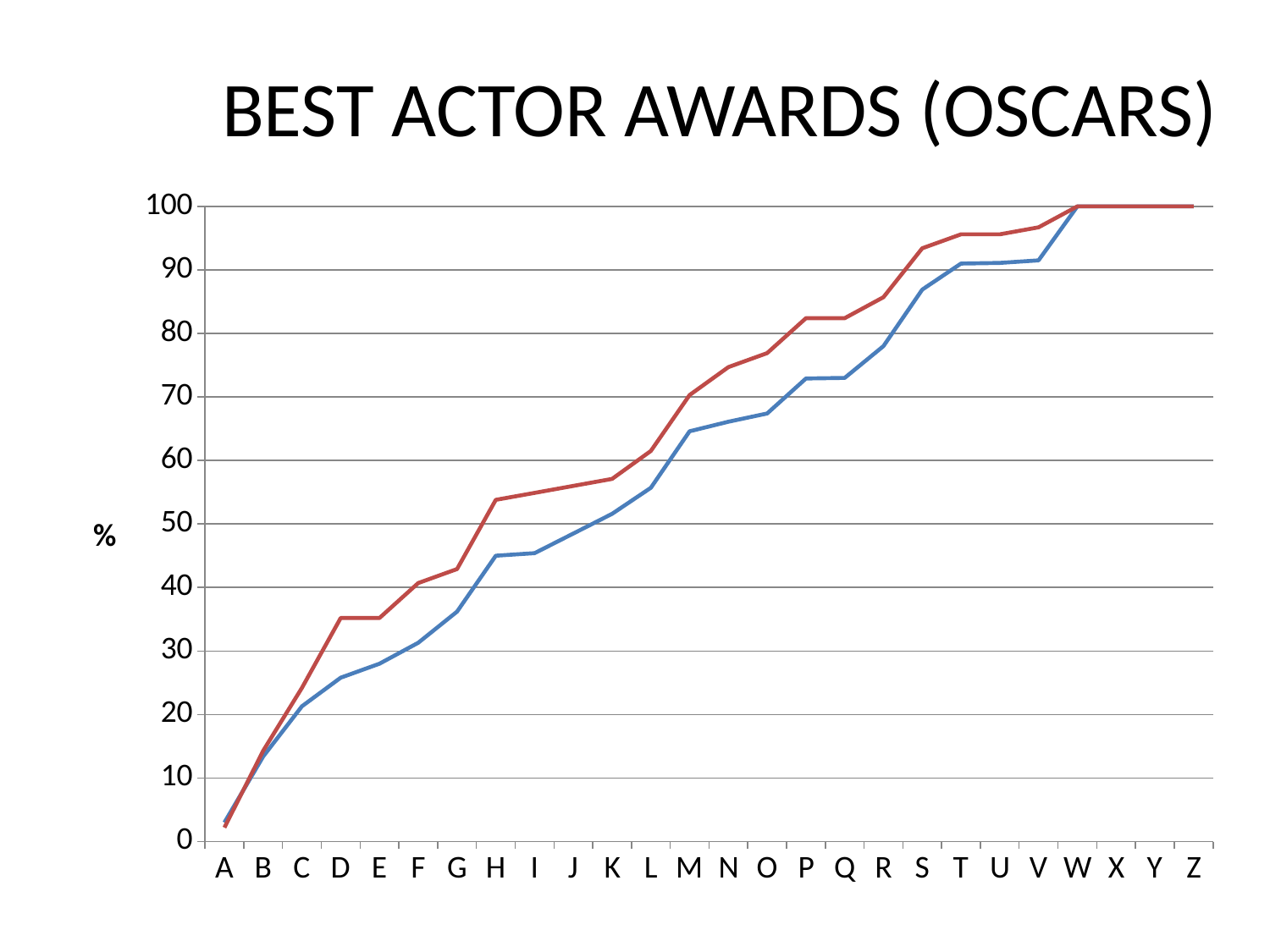
Is the value of the blue line at H greater or less than 50? less Is the value of the blue line at M greater or less than 60? greater What is the title of the chart? BEST ACTOR AWARDS (OSCARS) At which category does the blue line have its lowest value? A How many categories are shown along the x axis? 26 How many lines are plotted on the chart? 2 At K, which line has the higher value, the red line or the blue line? red line What is the value of the blue line at W? 100 Do the values of the red line rise or fall from A to Z? rise Is the value of the red line at D greater or less than 30? greater What kind of chart is shown on the slide? line chart What is the value of the red line at Z? 100